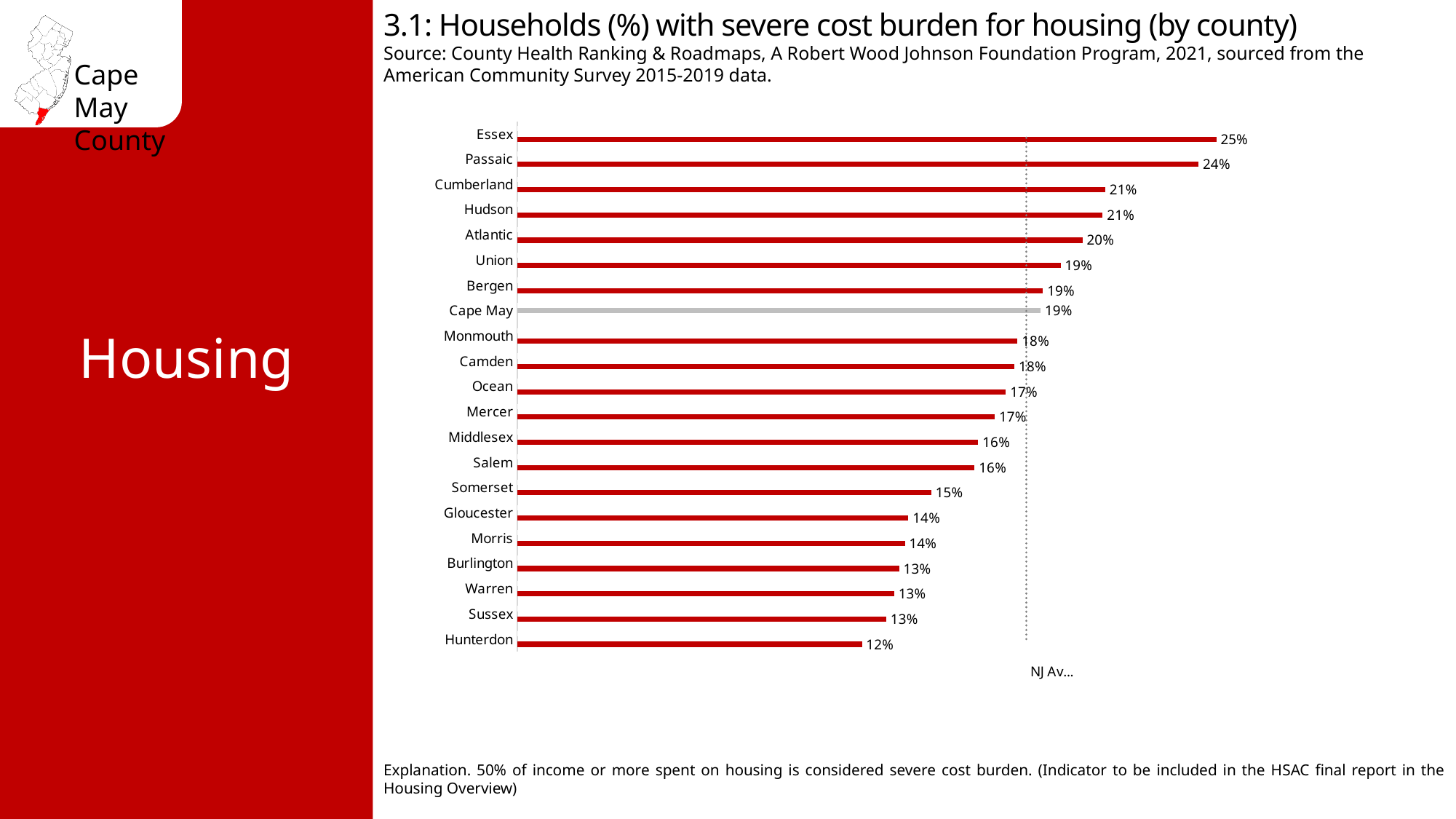
What is the value for Cape May? 19% Which county's bar is shown in grey rather than red? Cape May What kind of chart is this? Bar chart How many counties are shown in the chart? 21 What is the value for Hunterdon? 12% Which is larger, the value for Atlantic or the value for Middlesex? Atlantic What is the difference between the values for Essex and Hunterdon? 13% What is the difference between the values for Passaic and Cape May? 5% Which county has the lowest percentage of households with severe cost burden? Hunterdon Which county has the highest percentage of households with severe cost burden? Essex What is the value for Essex? 25% What is the value for Somerset? 15%